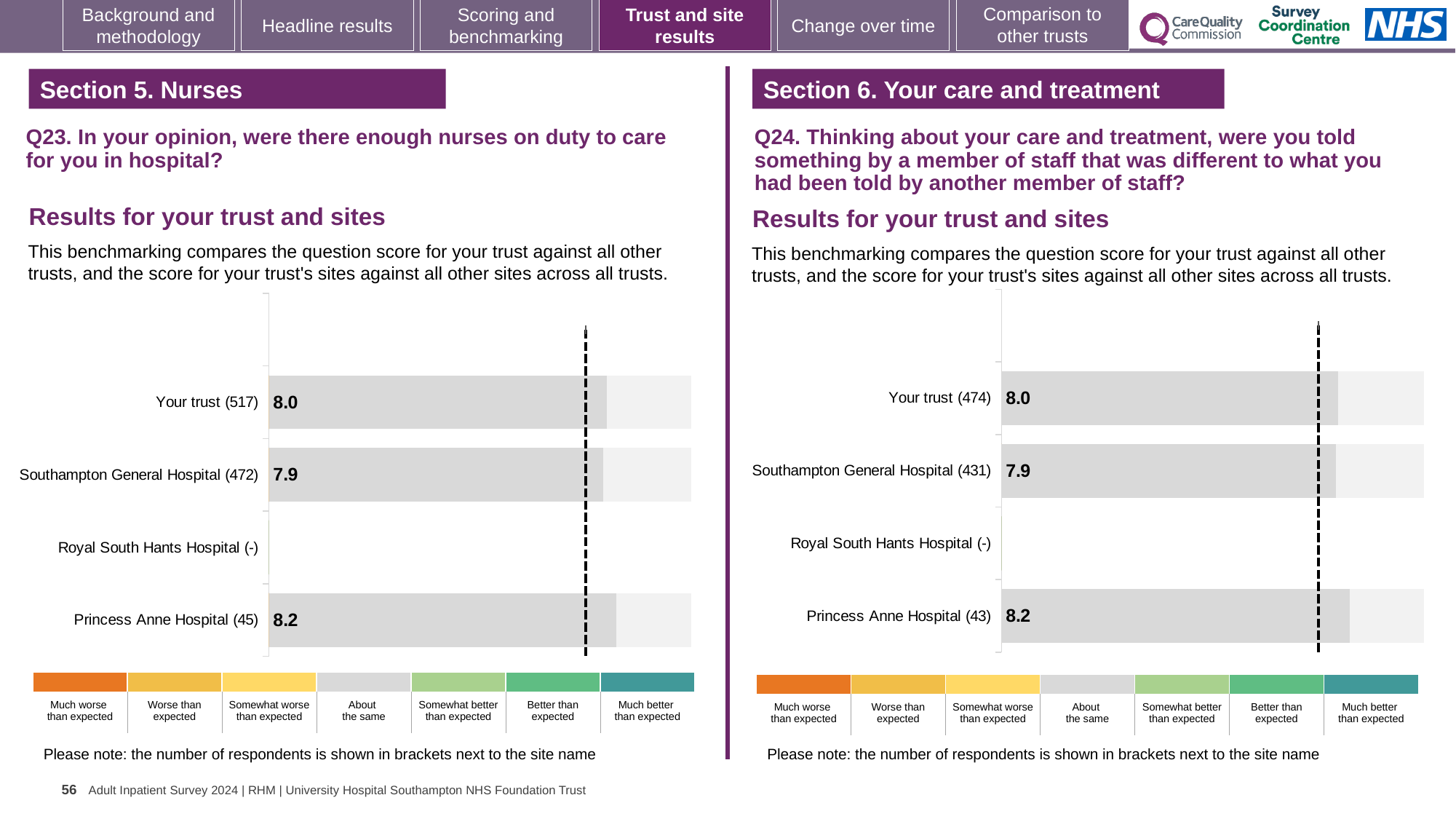
On the Q24 chart (right), how many respondents are shown in brackets for Your trust? 474 On the Q23 chart (left), what is the score for Princess Anne Hospital? 8.2 How many rows (sites or trust) are listed on the Q23 chart (left)? 4 How many categories does the colour legend below each chart list? 7 What kind of chart is used on the Q24 chart (right)? Bar chart On the Q24 chart (right), what is the score for Southampton General Hospital? 7.9 On the Q24 chart (right), which is larger: the score for Your trust or the score for Southampton General Hospital? Your trust On the Q23 chart (left), what is the score for Your trust? 8.0 On the Q23 chart (left), how many respondents are shown in brackets for Princess Anne Hospital? 45 On the Q24 chart (right), which site or trust has the highest score? Princess Anne Hospital On the Q23 chart (left), what is the difference between the scores for Princess Anne Hospital and Southampton General Hospital? 0.3 On the Q23 chart (left), which labelled score is the lowest? Southampton General Hospital